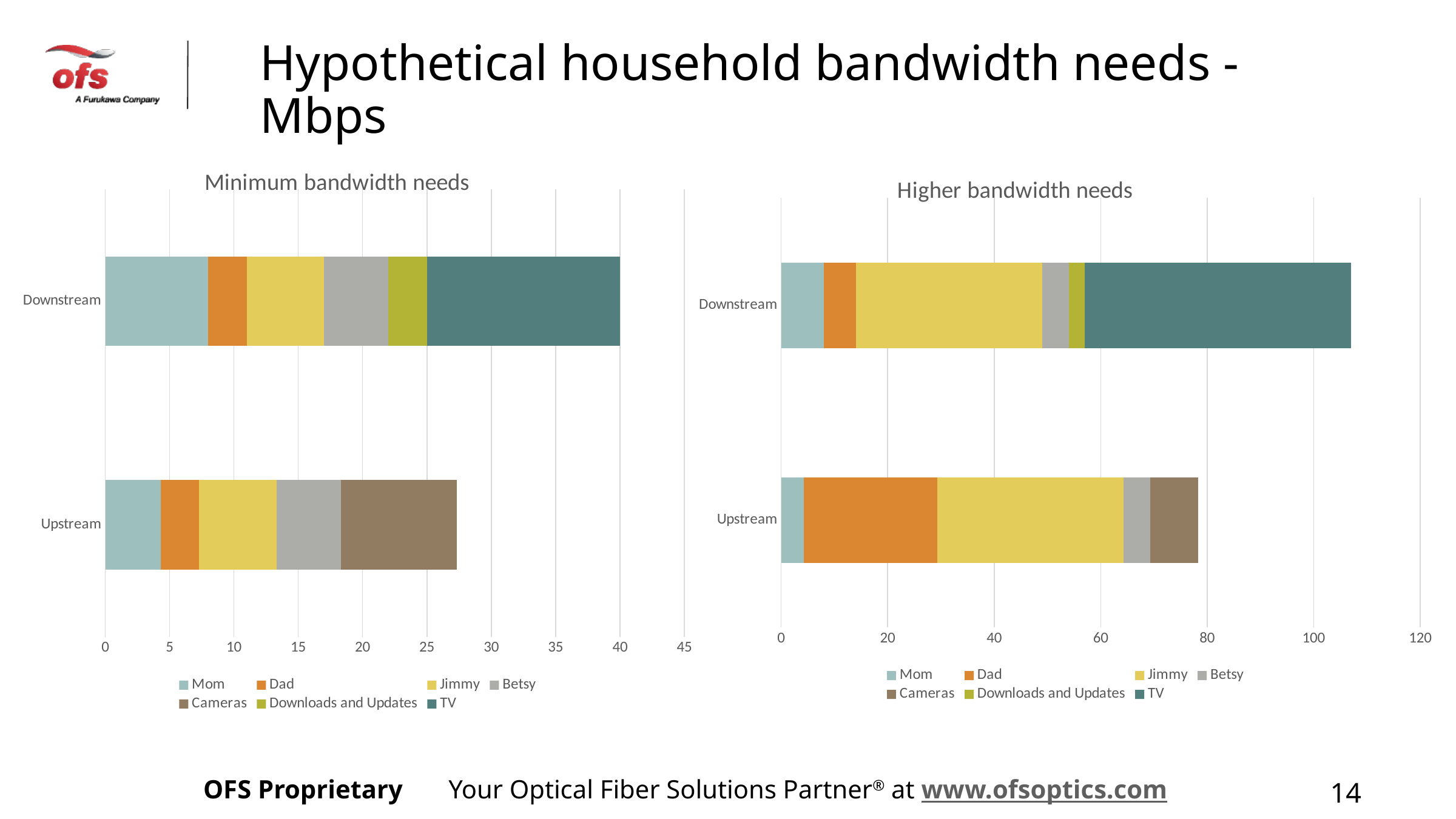
In the "Higher bandwidth needs" chart, is the total for Downstream greater or less than 100? greater In the "Minimum bandwidth needs" chart, is the total for Upstream greater or less than 30? less In the "Higher bandwidth needs" chart, is the Upstream total greater or less than 60? greater In the "Minimum bandwidth needs" chart, which category has the larger total bar, Downstream or Upstream? Downstream How many series does the legend of the "Higher bandwidth needs" chart list? 7 In the "Minimum bandwidth needs" chart, which series is shown in dark teal? TV How many categories are shown on the y axis of the "Minimum bandwidth needs" chart? 2 In the "Higher bandwidth needs" chart, which category has the smaller total bar? Upstream What kind of chart is the "Minimum bandwidth needs" chart? Stacked bar chart What is the title of the chart on the right side of the slide? Higher bandwidth needs